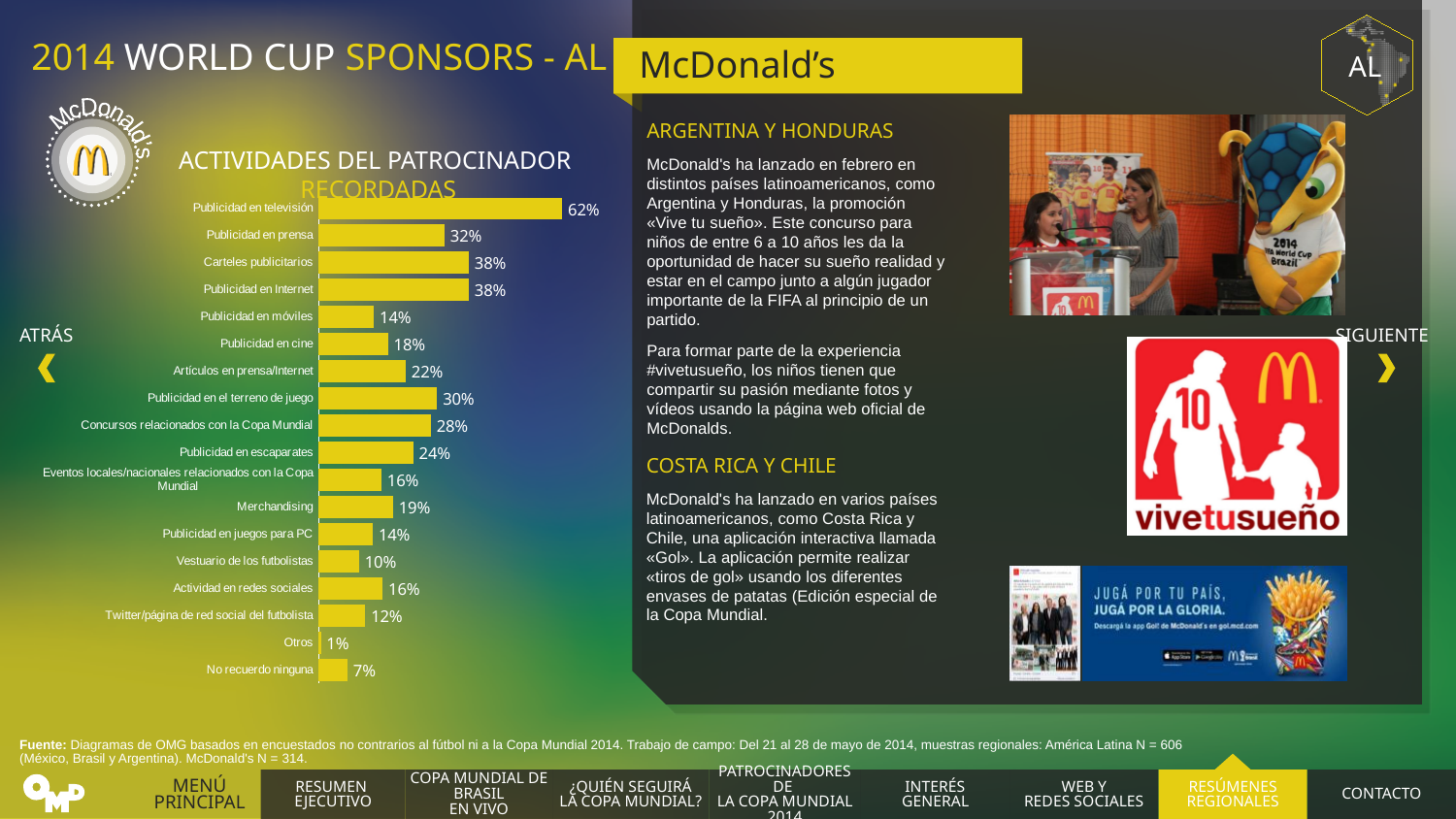
Which is larger, the value for "Concursos relacionados con la Copa Mundial" or the value for "Publicidad en escaparates"? Concursos relacionados con la Copa Mundial Which category has the lowest value in the chart? Otros What is the title of the chart on the slide? ACTIVIDADES DEL PATROCINADOR RECORDADAS What is the value for "Publicidad en televisión"? 62% What is the value for "Publicidad en el terreno de juego"? 30% What type of chart is shown under the title "ACTIVIDADES DEL PATROCINADOR RECORDADAS"? Bar chart What is the difference between the values for "Carteles publicitarios" and "Publicidad en cine"? 20% How many categories are shown in the chart? 18 What is the difference between the values for "Publicidad en televisión" and "Publicidad en prensa"? 30% What is the value for "Merchandising"? 19% What is the value for "No recuerdo ninguna"? 7% Which category has the highest value in the chart? Publicidad en televisión